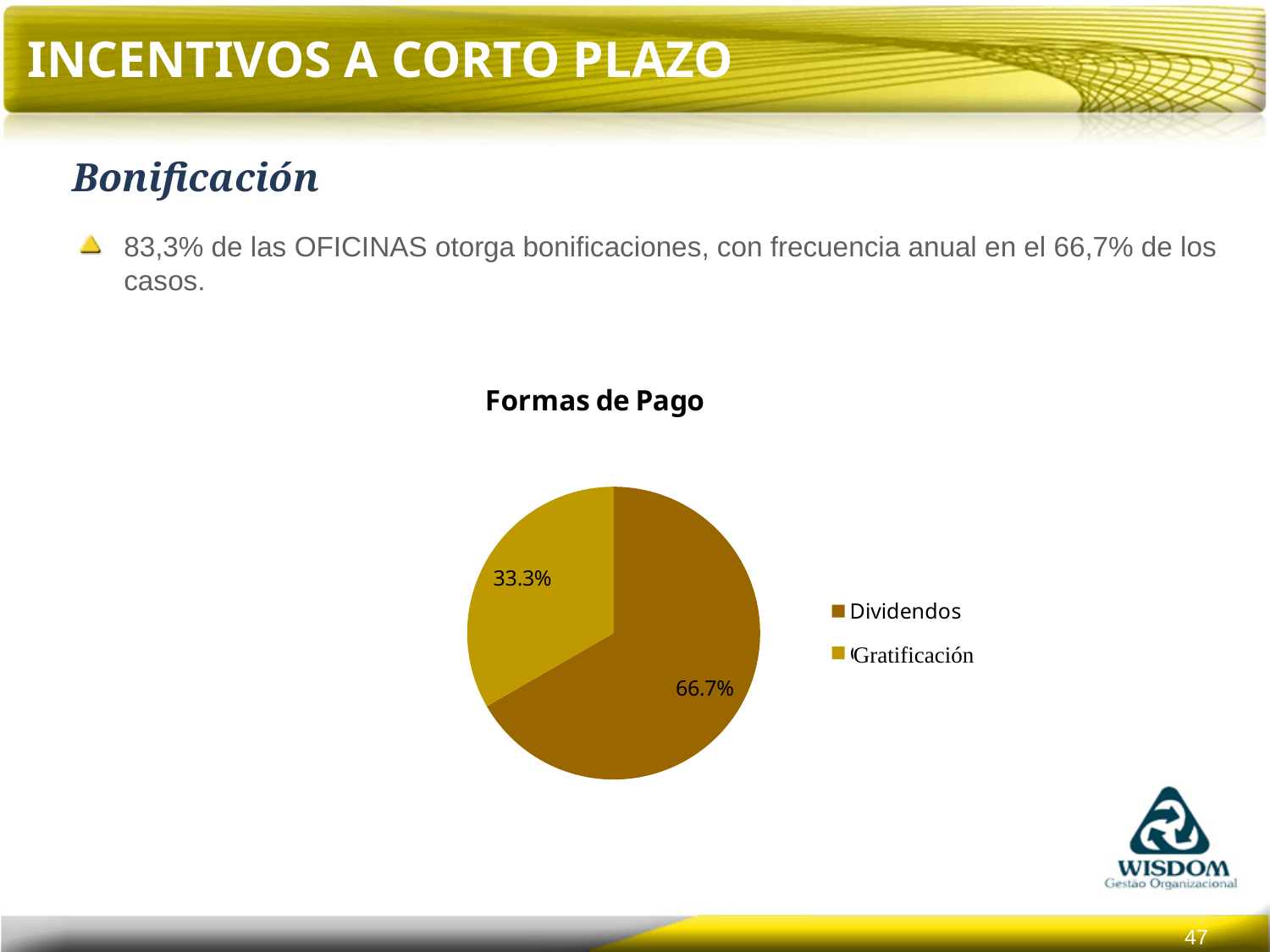
What share of the pie does Dividendos represent? 66.7% What is the difference in percentage points between the Dividendos slice and the Gratificación slice? 33.4 How many entries does the legend list? 2 Is the share for Gratificación greater or less than 50%? less What share of the pie does Gratificación represent? 33.3% What type of chart is shown on the slide? pie chart Which category has the smallest slice of the pie? Gratificación Which is larger, the slice for Dividendos or the slice for Gratificación? Dividendos How many categories are shown in the pie chart? 2 Which category has the largest slice of the pie? Dividendos What is the title of the chart? Formas de Pago